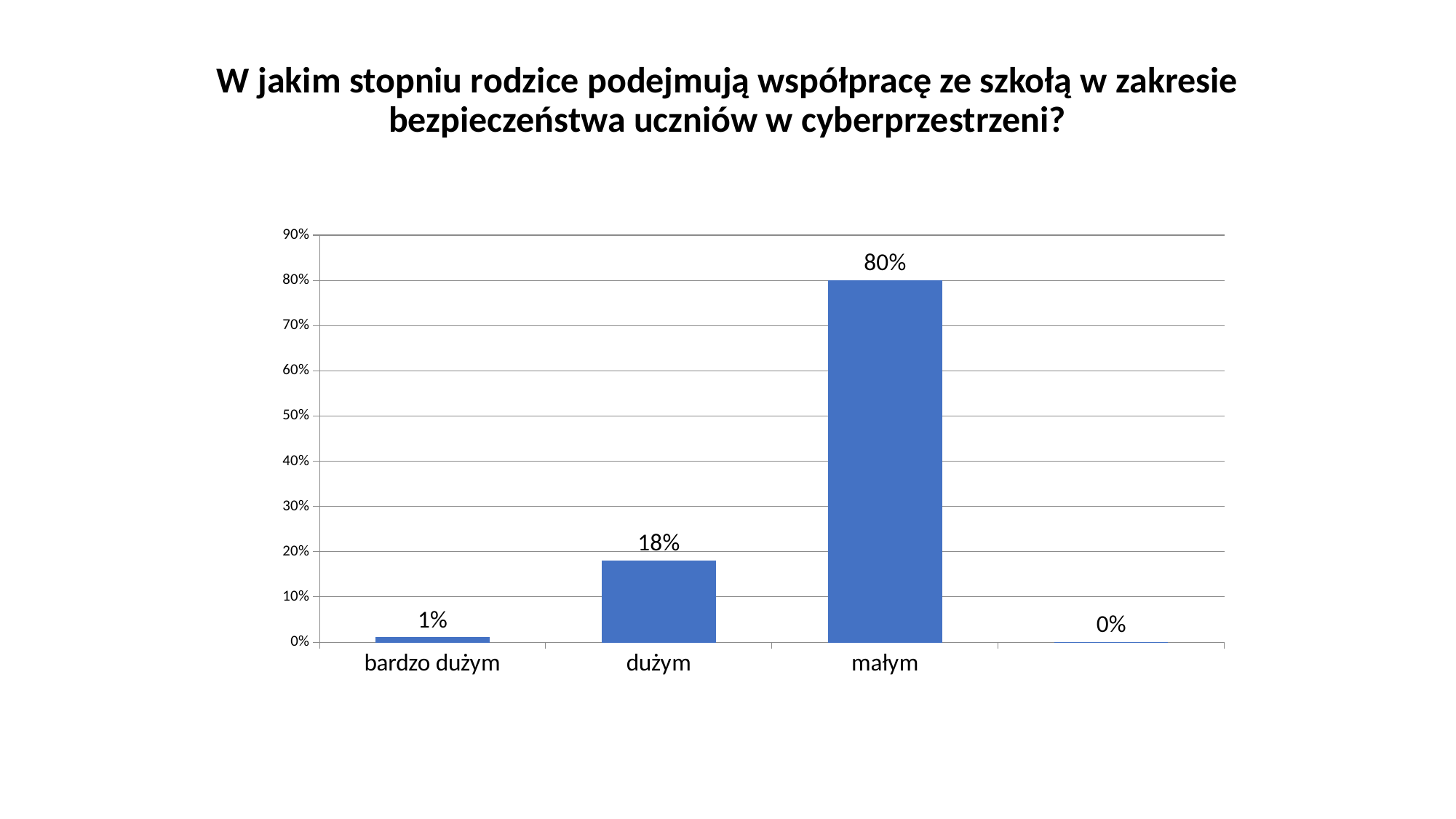
What is the highest value shown on the vertical axis? 90% How many data labels are printed on the chart? 4 What is the difference between the values for "dużym" and "bardzo dużym"? 17 percentage points Is the value for "małym" greater or less than 70%? greater What is the difference between the values for "małym" and "dużym"? 62 percentage points What is the value for "małym"? 80% Which category has the highest value? małym Is the value for "dużym" greater or less than 20%? less What is the value for "bardzo dużym"? 1% What is the value for "dużym"? 18% Which is larger, the value for "dużym" or the value for "bardzo dużym"? dużym What kind of chart is shown on the slide? bar chart